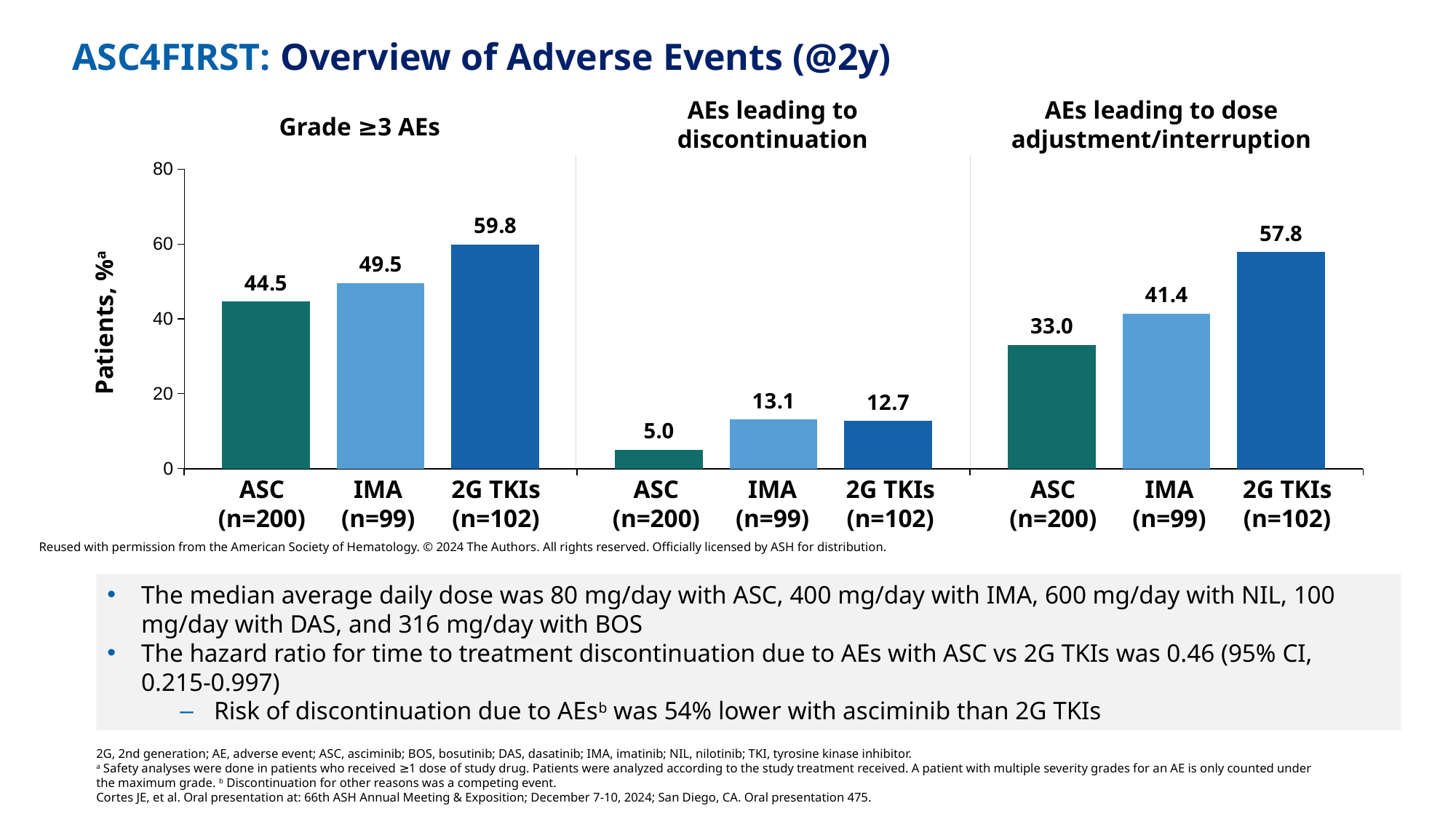
What is the label of the y axis of the chart? Patients, % In the AEs leading to dose adjustment/interruption panel, what is the difference between the 2G TKIs value and the ASC value? 24.8 In the AEs leading to discontinuation panel, what value is shown for IMA (n=99)? 13.1 In the Grade ≥3 AEs panel, what is the difference between the 2G TKIs value and the IMA value? 10.3 In the Grade ≥3 AEs panel, which treatment group has the highest value? 2G TKIs (n=102) In the AEs leading to discontinuation panel, which treatment group has the lowest value? ASC (n=200) How many bars are plotted in total across the three panels of the chart? 9 Is the value for ASC in the AEs leading to discontinuation panel greater or less than 20? less What type of chart is shown on the slide? Bar chart In the AEs leading to dose adjustment/interruption panel, what value is shown for 2G TKIs (n=102)? 57.8 In the Grade ≥3 AEs panel, what percentage of patients is shown for ASC (n=200)? 44.5 In the AEs leading to dose adjustment/interruption panel, which is larger, the value for ASC or the value for IMA? IMA